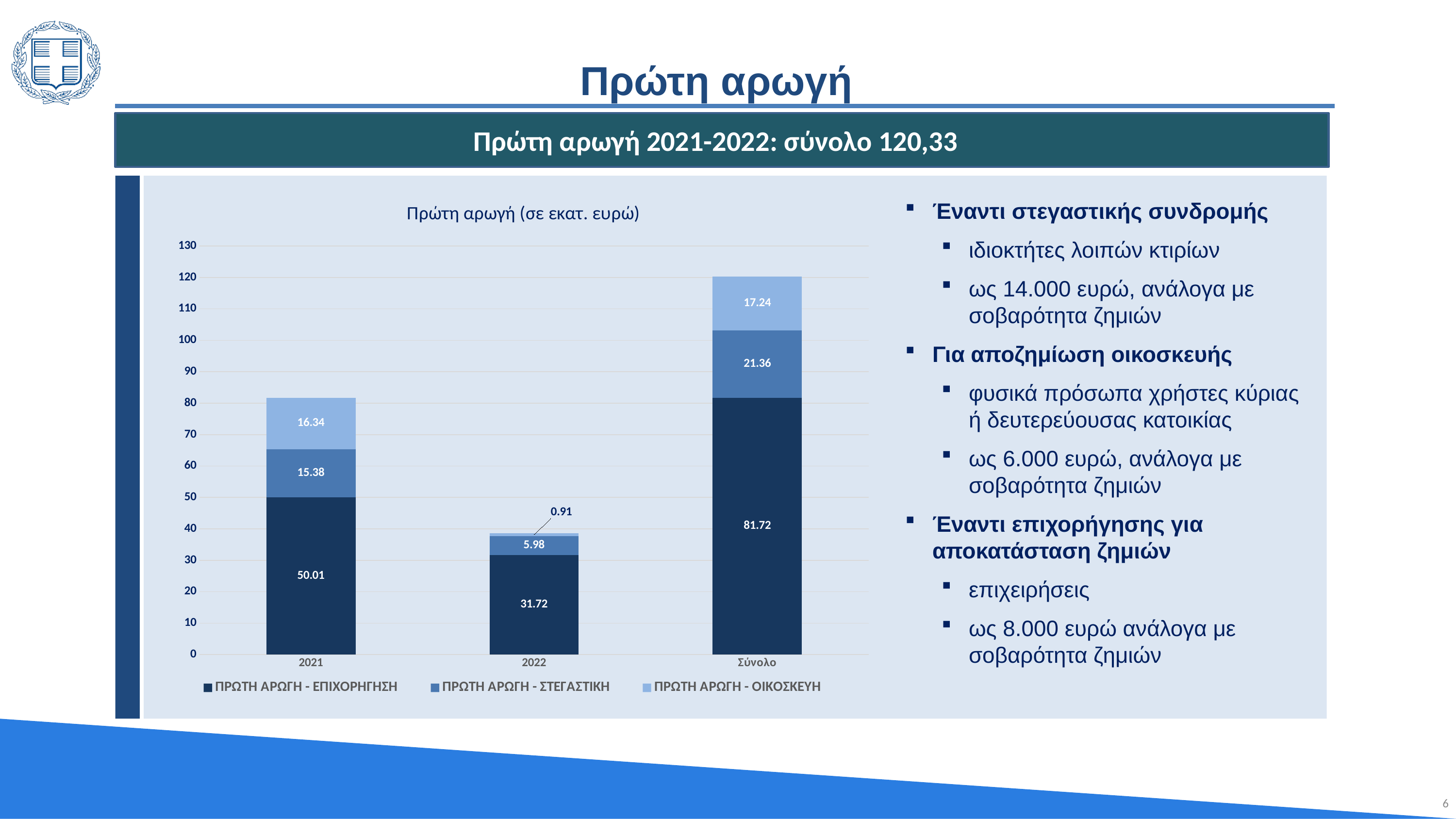
What is the difference between ΠΡΩΤΗ ΑΡΩΓΗ - ΕΠΙΧΟΡΗΓΗΣΗ in 2021 and in 2022? 18.29 How many categories are shown on the x axis? 3 What kind of chart is shown on the slide? Stacked bar chart What is the value of ΠΡΩΤΗ ΑΡΩΓΗ - ΣΤΕΓΑΣΤΙΚΗ for 2022? 5.98 What is the value of ΠΡΩΤΗ ΑΡΩΓΗ - ΟΙΚΟΣΚΕΥΗ for Σύνολο? 17.24 Which is larger for 2021: ΠΡΩΤΗ ΑΡΩΓΗ - ΣΤΕΓΑΣΤΙΚΗ or ΠΡΩΤΗ ΑΡΩΓΗ - ΟΙΚΟΣΚΕΥΗ? ΠΡΩΤΗ ΑΡΩΓΗ - ΟΙΚΟΣΚΕΥΗ What is the value of ΠΡΩΤΗ ΑΡΩΓΗ - ΕΠΙΧΟΡΗΓΗΣΗ for 2021? 50.01 What is the total of the stacked bar for 2022? 38.61 How many series does the legend list? 3 What is the total of the stacked bar for 2021? 81.73 What is the value of ΠΡΩΤΗ ΑΡΩΓΗ - ΟΙΚΟΣΚΕΥΗ for 2022? 0.91 Which category has the lowest ΠΡΩΤΗ ΑΡΩΓΗ - ΕΠΙΧΟΡΗΓΗΣΗ value? 2022